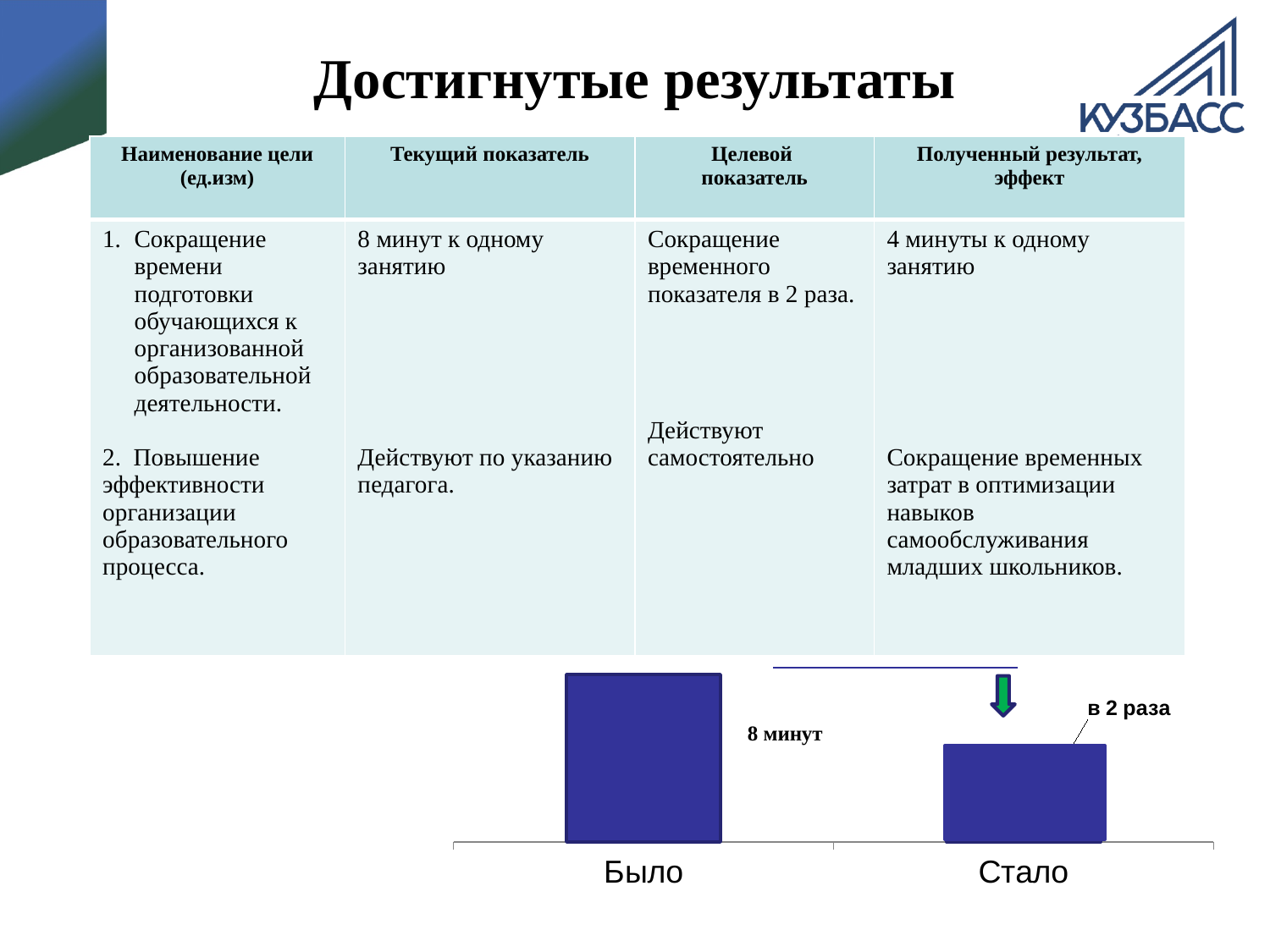
What annotation text is shown next to the Стало bar in the chart? в 2 раза How many categories does the bar chart at the bottom of the slide have? 2 In the bar chart, is the bar for Было larger or smaller than the bar for Стало? larger What are the two category labels on the x axis of the bar chart? Было, Стало Which category in the bar chart has the lowest bar? Стало Which category in the bar chart has the highest bar? Было What kind of chart is shown at the bottom of the slide? bar chart What value is labelled next to the Было bar in the chart? 8 минут Do the bar values rise or fall from Было to Стало? fall